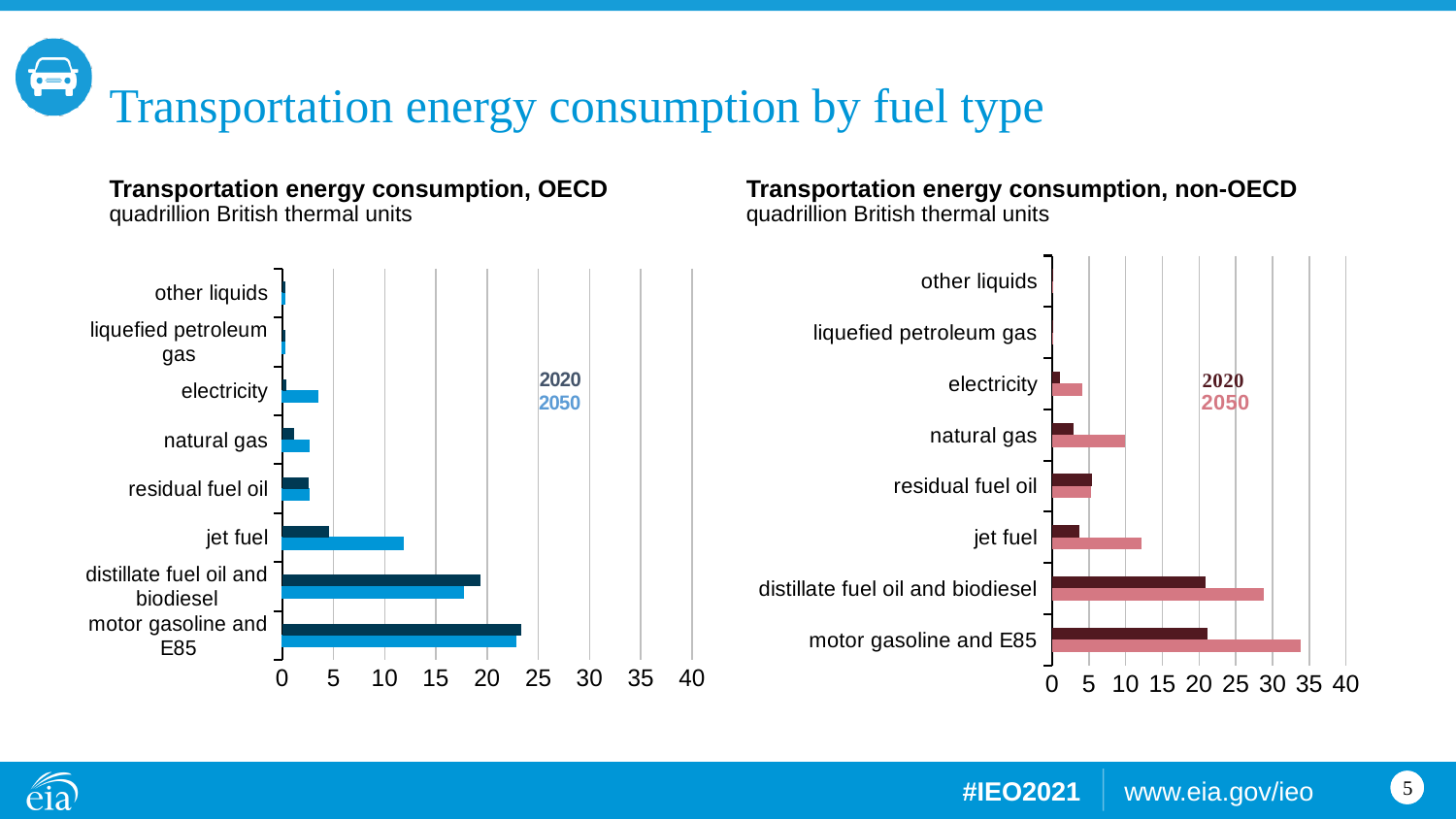
On the 'Transportation energy consumption, non-OECD' chart, is the 2020 value for distillate fuel oil and biodiesel greater or less than 25? less On the 'Transportation energy consumption, OECD' chart, is the 2050 value for electricity greater or less than 5? less On the 'Transportation energy consumption, OECD' chart, which fuel type has the highest 2020 value? motor gasoline and E85 What unit is given in the subtitle of the 'Transportation energy consumption, OECD' chart? quadrillion British thermal units On the 'Transportation energy consumption, non-OECD' chart, which fuel type has the highest 2050 value? motor gasoline and E85 What kind of chart is the 'Transportation energy consumption, OECD' chart? bar chart How many fuel-type categories are shown on the 'Transportation energy consumption, OECD' chart? 8 On the 'Transportation energy consumption, OECD' chart, is the 2050 value for jet fuel greater or less than 10? greater How many series does the legend of the 'Transportation energy consumption, non-OECD' chart list? 2 On the 'Transportation energy consumption, non-OECD' chart, which is larger for natural gas, the 2020 value or the 2050 value? 2050 On the 'Transportation energy consumption, OECD' chart, which is larger for jet fuel, the 2020 value or the 2050 value? 2050